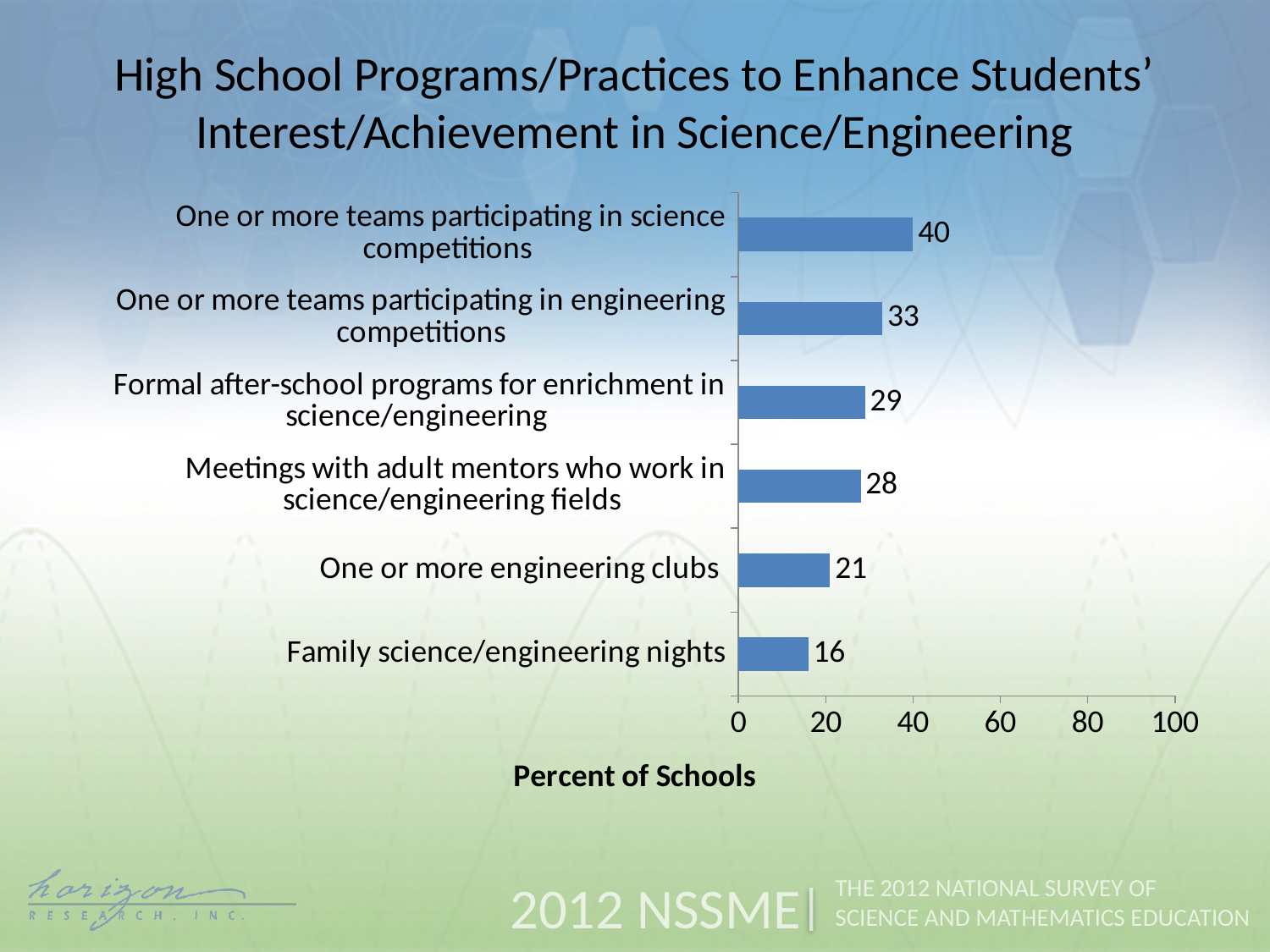
What percent of schools have one or more teams participating in science competitions? 40 What is the label of the horizontal axis? Percent of Schools Which category has the lowest percent of schools? Family science/engineering nights How many categories are shown in the chart? 6 What is the value for 'Meetings with adult mentors who work in science/engineering fields'? 28 Which category has the highest percent of schools? One or more teams participating in science competitions What is the value for 'Family science/engineering nights'? 16 What is the maximum value shown on the horizontal axis? 100 Is the value for 'Formal after-school programs for enrichment in science/engineering' greater or less than 40? less What kind of chart is shown on the slide? Bar chart Which is larger: the value for 'One or more engineering clubs' or 'Family science/engineering nights'? One or more engineering clubs What is the difference between the values for science competitions teams and engineering competitions teams? 7